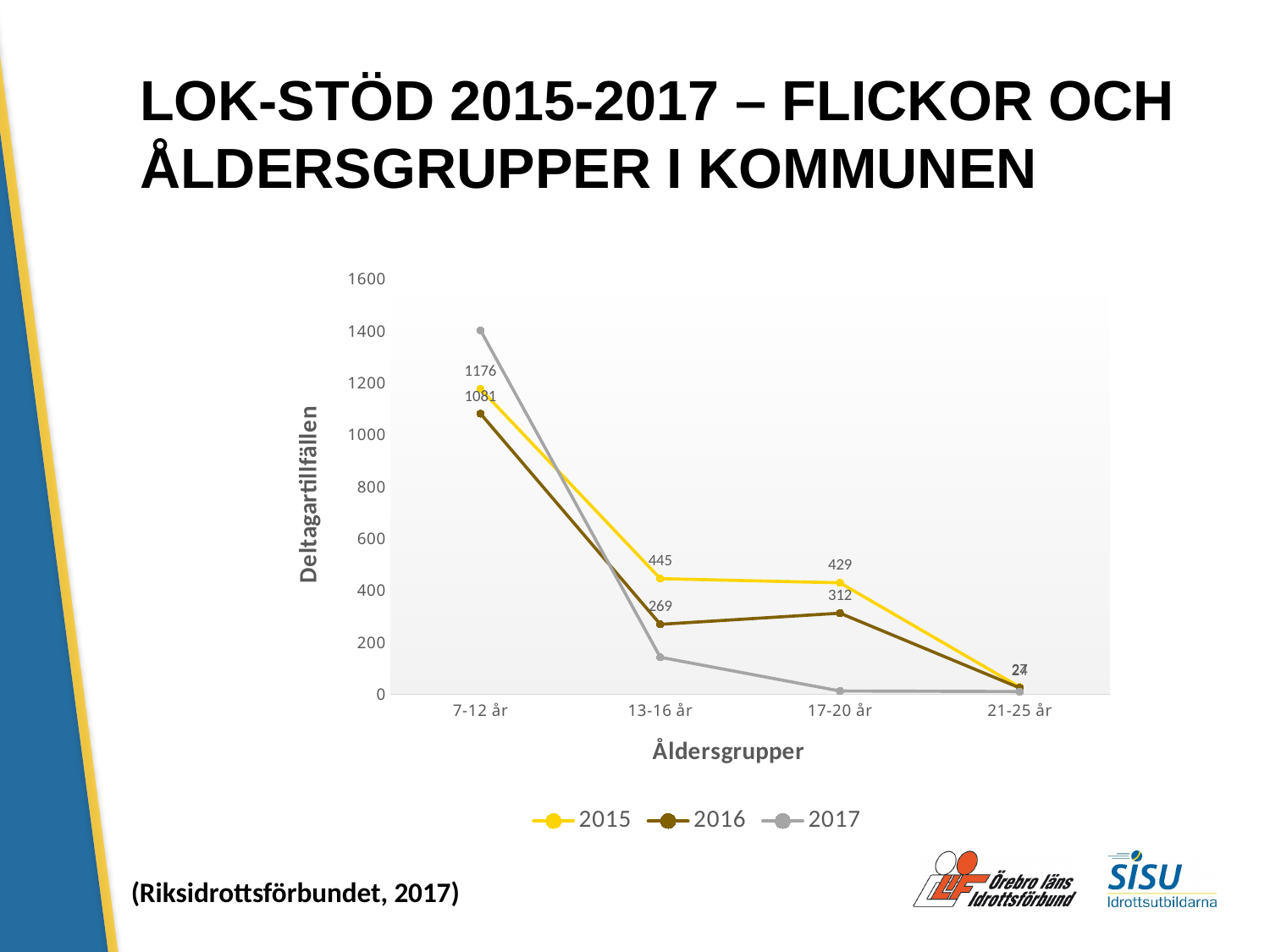
How many series does the legend list? 3 Which is larger in the 17-20 år age group, the 2015 value or the 2016 value? 2015 What is the value for 2016 in the 7-12 år age group? 1081 What kind of chart is shown on the slide? line chart What is the value for 2015 in the 13-16 år age group? 445 What is the value for 2015 in the 7-12 år age group? 1176 Do the values for the 2017 series rise or fall from 7-12 år to 21-25 år? fall How many age groups are shown on the x axis? 4 What is the label on the y axis? Deltagartillfällen What is the difference between the 2015 and 2016 values in the 13-16 år age group? 176 What is the value for 2016 in the 17-20 år age group? 312 Is the value for 2017 in the 7-12 år age group greater or less than 1200? greater